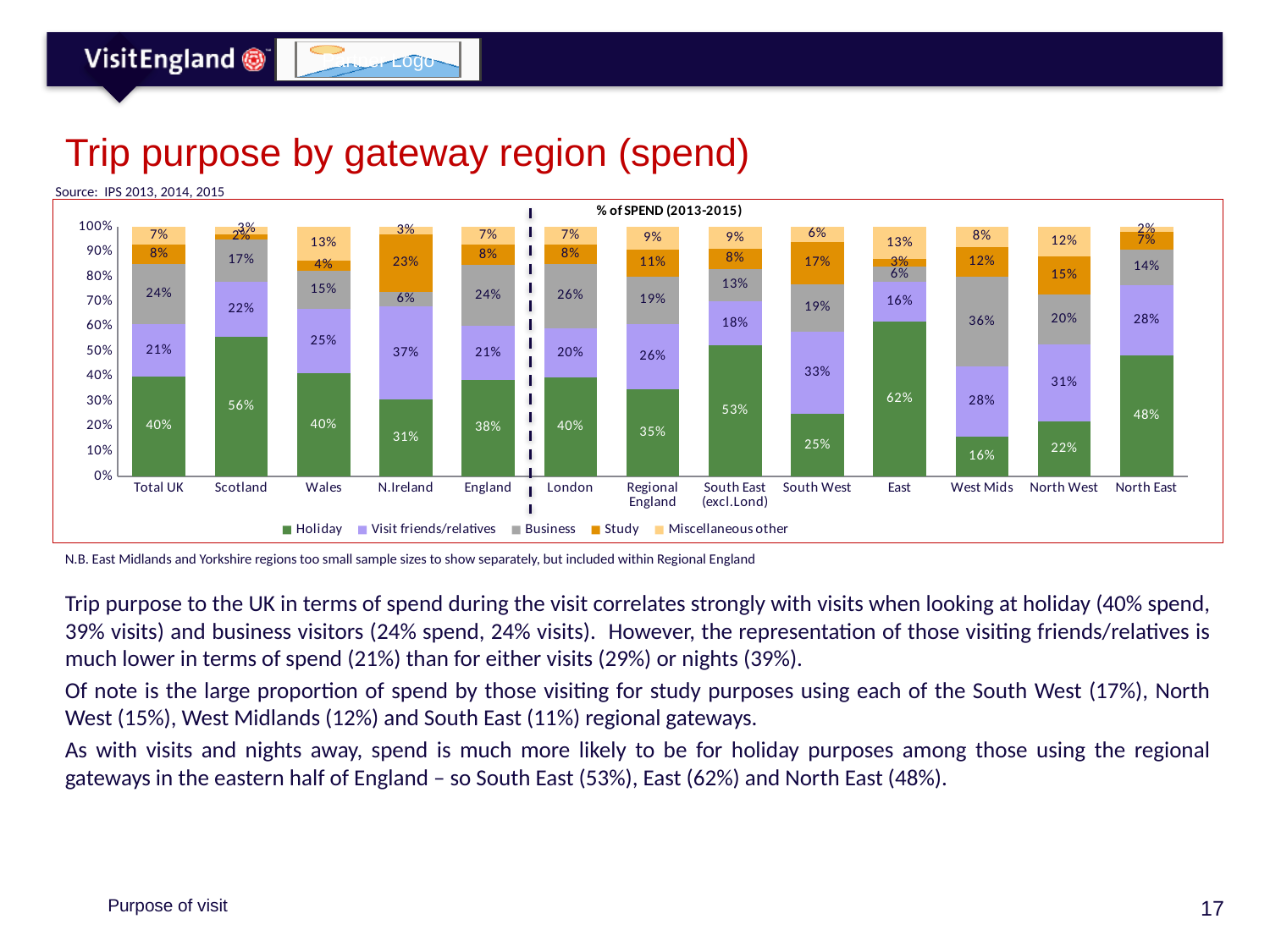
Which gateway region has the lowest Holiday share of spend? West Mids What is the title of the chart? % of SPEND (2013-2015) What is the Visit friends/relatives share of spend for South West? 33% Which has a larger Study share of spend, South West or North West? South West What is the difference between the Holiday share of spend for Scotland and for Wales? 16 percentage points How many series does the legend list? 5 What is the Holiday share of spend for the East gateway region? 62% What is the Study share of spend for N.Ireland? 23% What kind of chart is shown on the slide? Stacked bar chart How many gateway regions (categories) are shown on the x axis? 13 What is the Business share of spend for West Mids? 36% Which gateway region has the highest Holiday share of spend? East